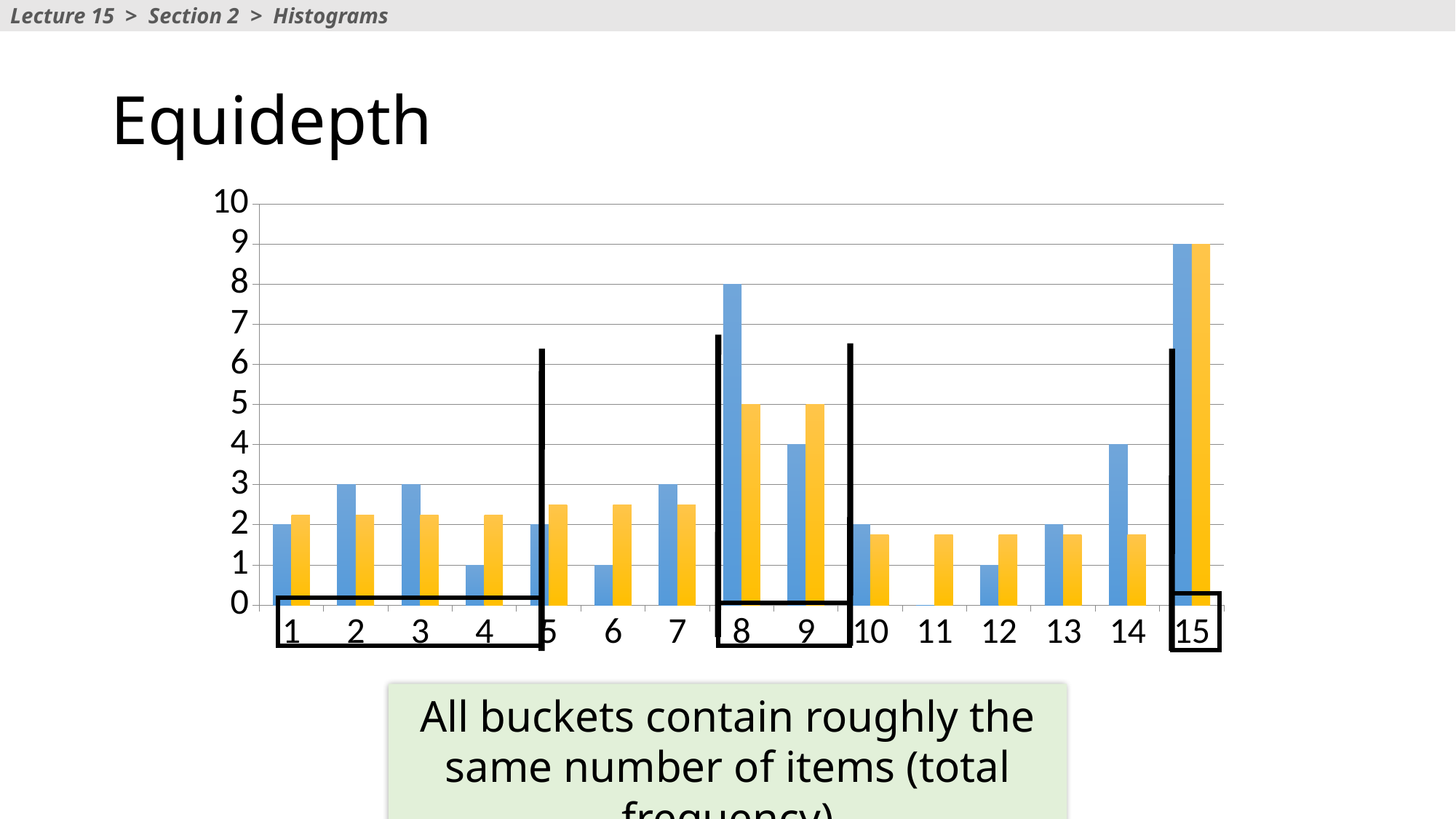
What is the value of the blue bar for category 14? 4 What is the value of the blue bar for category 15? 9 What kind of chart is shown on the slide? bar chart Is the orange bar for category 10 greater or less than 2? less What is the difference between the blue bar for category 8 and the blue bar for category 9? 4 What is the value of the blue bar for category 8? 8 How many black-outlined buckets are drawn on the chart? 3 What is the title of the slide containing the chart? Equidepth What is the value of the orange bar for category 9? 5 Which category has the highest blue bar? 15 How many categories are shown along the x axis of the chart? 15 Which is larger, the blue bar for category 8 or the blue bar for category 9? category 8